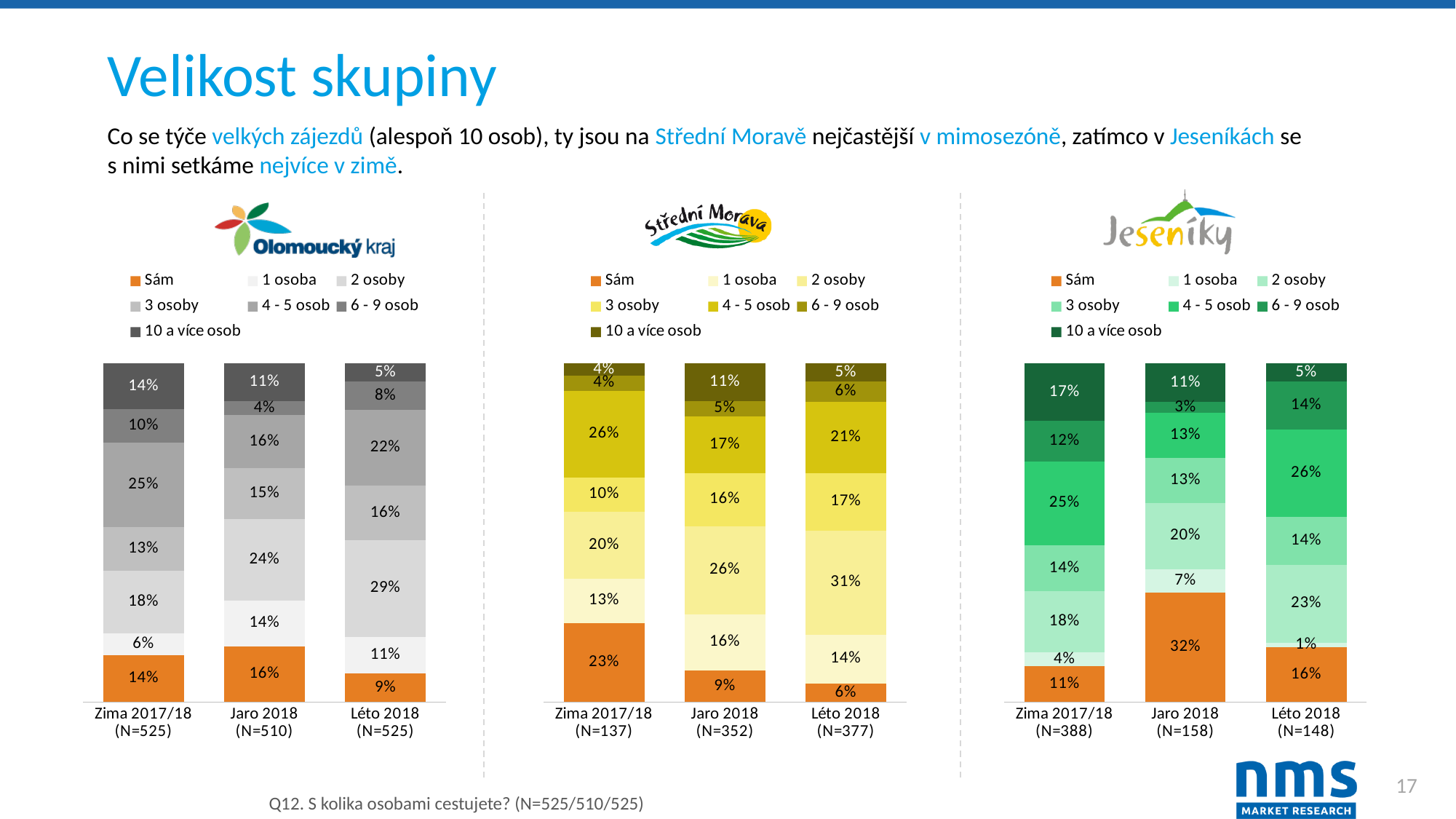
In the Střední Morava chart, which season has the lowest value for 'Sám'? Léto 2018 In the Jeseníky chart, which is larger: the '4 - 5 osob' value in Léto 2018 or in Jaro 2018? Léto 2018 What kind of chart is the Střední Morava chart? Stacked bar chart How many seasons (categories) are shown in the Olomoucký kraj chart? 3 In the Olomoucký kraj chart, what is the value for 'Sám' in Zima 2017/18? 14% What is the sample size (N) shown for Zima 2017/18 in the Střední Morava chart? N=137 In the Olomoucký kraj chart, what is the difference between the '2 osoby' values for Léto 2018 and Zima 2017/18? 11% In the Střední Morava chart, what is the value for '10 a více osob' in Jaro 2018? 11% In the Střední Morava chart, what is the difference between the '2 osoby' values for Léto 2018 and Zima 2017/18? 11% How many series does the legend of the Jeseníky chart list? 7 In the Jeseníky chart, what is the value for 'Sám' in Jaro 2018? 32% In the Jeseníky chart, which season has the highest value for '10 a více osob'? Zima 2017/18